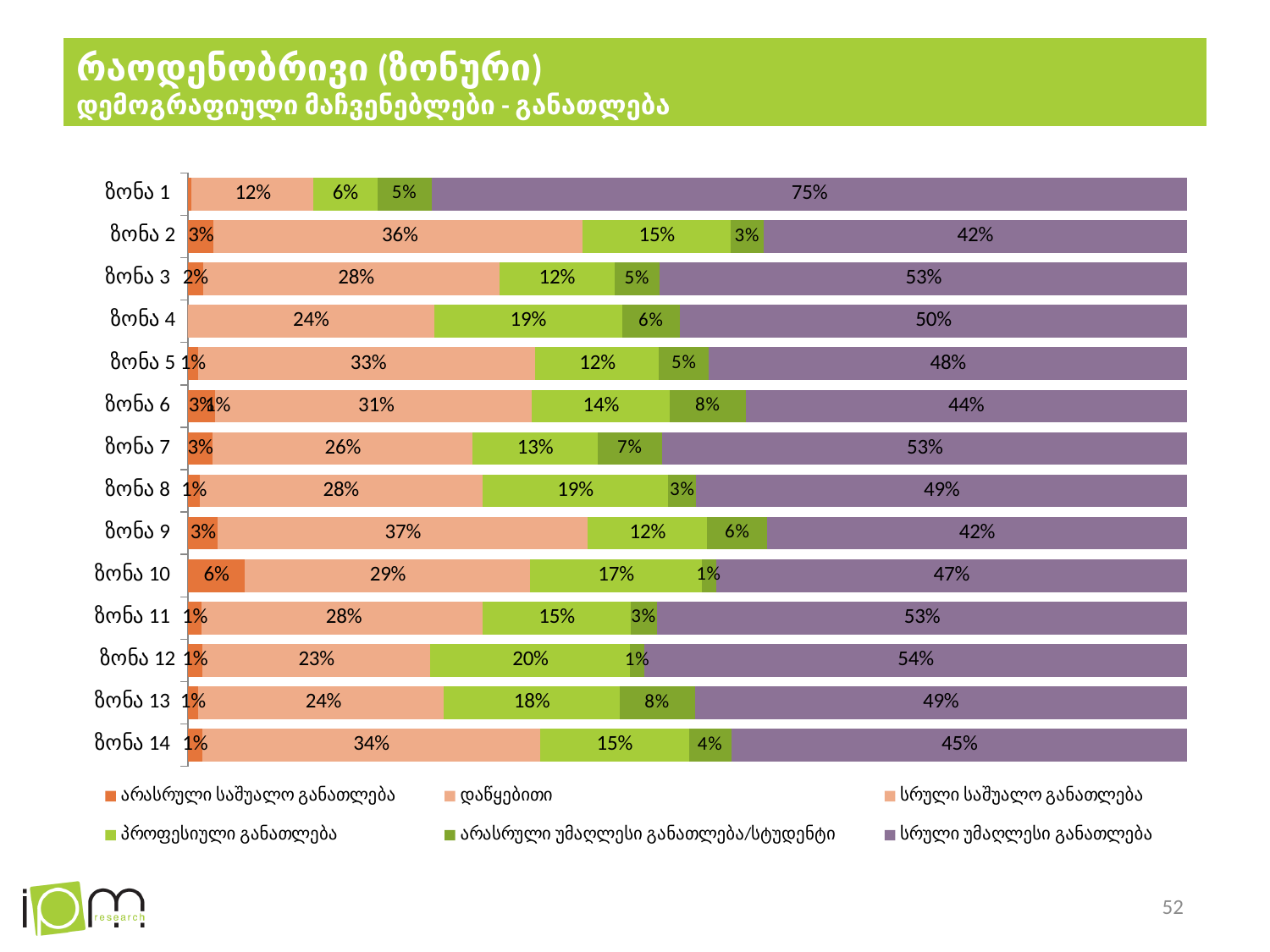
What is the value of პროფესიული განათლება (light green) for ზონა 6? 14% How many zones (ზონა) are plotted in the chart? 14 How many series does the legend list? 6 Which zone has the highest share of სრული უმაღლესი განათლება (purple)? ზონა 1 Which zone has the highest share of პროფესიული განათლება (light green)? ზონა 12 What is the difference in სრული უმაღლესი განათლება (purple) between ზონა 1 and ზონა 14? 30 percentage points What is the subtitle of the slide below რაოდენობრივი (ზონური)? დემოგრაფიული მაჩვენებლები - განათლება What is the value of სრული უმაღლესი განათლება (purple) for ზონა 1? 75% Which has a larger share of სრული უმაღლესი განათლება (purple): ზონა 3 or ზონა 4? ზონა 3 What is the value of არასრული უმაღლესი განათლება/სტუდენტი (dark green) for ზონა 13? 8% What kind of chart is shown on the slide? Stacked bar chart What is the value of პროფესიული განათლება (light green) for ზონა 10? 17%